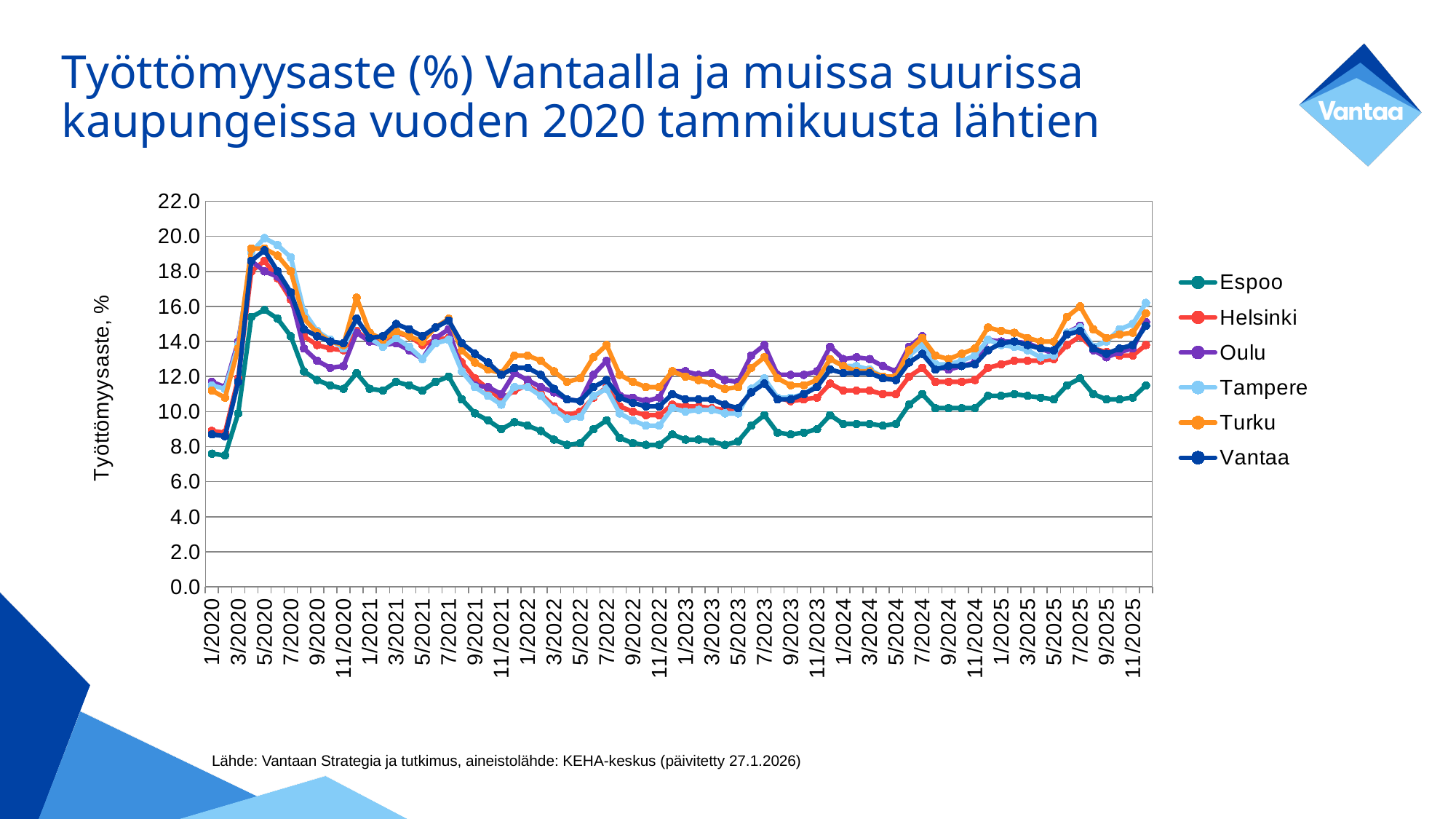
What kind of chart is shown on the slide? line chart Is the value for Tampere at 5/2020 greater or less than 18.0? greater Which city is listed last in the legend? Vantaa Is the value for Vantaa at 1/2020 greater or less than 8.0? greater Which series has the lowest value at 1/2023? Espoo Which is larger at 7/2023, the value for Espoo or the value for Vantaa? Vantaa Is the value for Espoo at 1/2020 greater or less than 8.0? less What is the label of the vertical axis? Työttömyysaste, % Does the Vantaa series rise or fall between 5/2020 and 9/2022? fall How many series does the legend list? 6 Does the Espoo series rise or fall between 1/2020 and 5/2020? rise